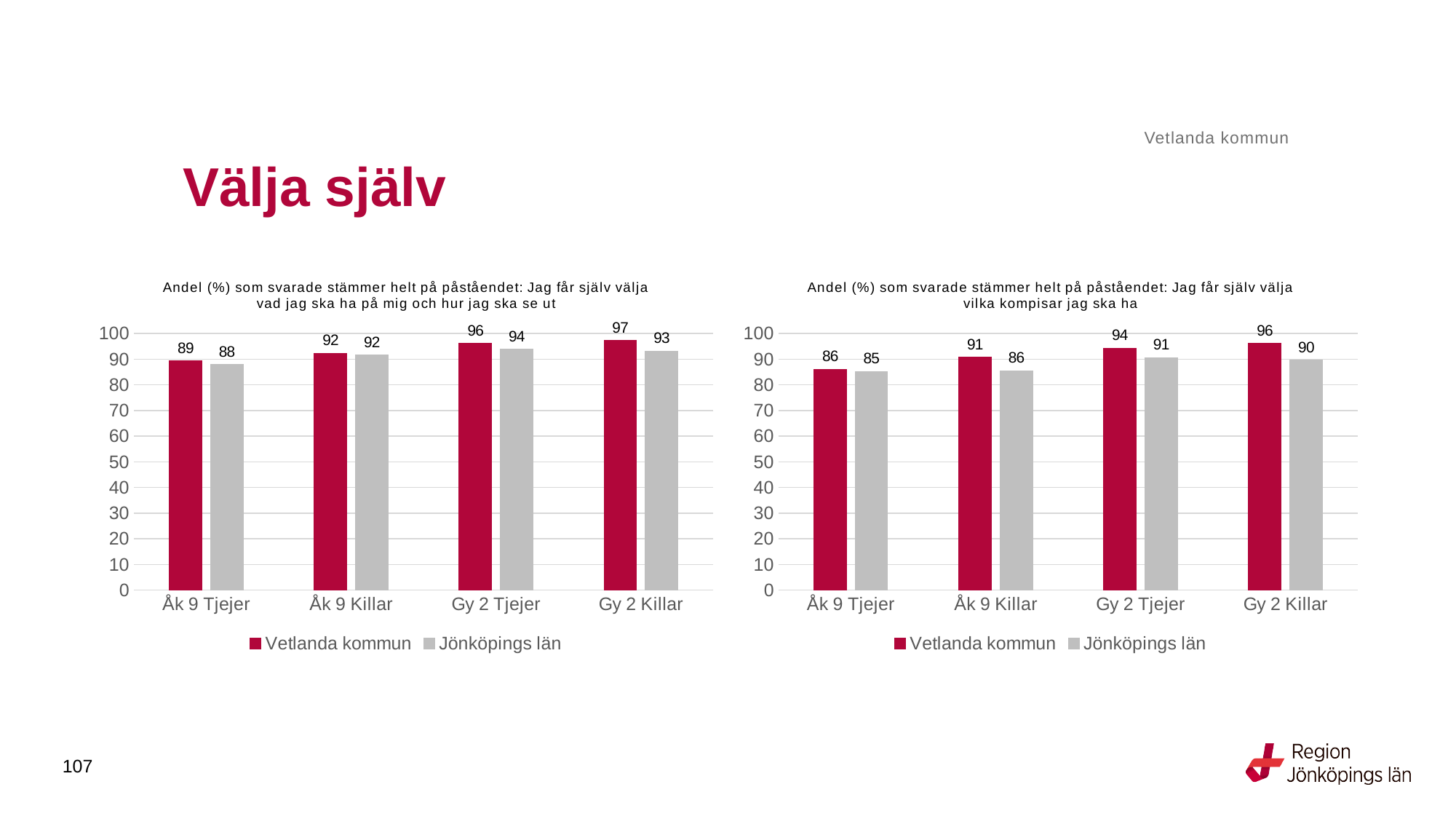
How many categories are shown on the x axis of the right chart (about choosing which friends to have)? 4 In the left chart (about choosing what to wear and how to look), do the Vetlanda kommun values rise or fall from Åk 9 Tjejer to Gy 2 Killar? Rise In the left chart (about choosing what to wear and how to look), which is larger for Gy 2 Tjejer: Vetlanda kommun or Jönköpings län? Vetlanda kommun In the right chart (about choosing which friends to have), what is the value for Jönköpings län for Åk 9 Killar? 86 In the right chart (about choosing which friends to have), which category has the lowest value for Vetlanda kommun? Åk 9 Tjejer In the right chart (about choosing which friends to have), what is the difference between Vetlanda kommun and Jönköpings län for Gy 2 Killar? 6 In the left chart (about choosing what to wear and how to look), what is the value for Jönköpings län for Åk 9 Tjejer? 88 In the right chart (about choosing which friends to have), what is the value for Vetlanda kommun for Gy 2 Tjejer? 94 How many series does the legend of the left chart (about choosing what to wear and how to look) list? 2 What kind of chart is the right chart (about choosing which friends to have)? Bar chart In the left chart (about choosing what to wear and how to look), what is the value for Vetlanda kommun for Gy 2 Killar? 97 In the left chart (about choosing what to wear and how to look), which category has the highest value for Vetlanda kommun? Gy 2 Killar